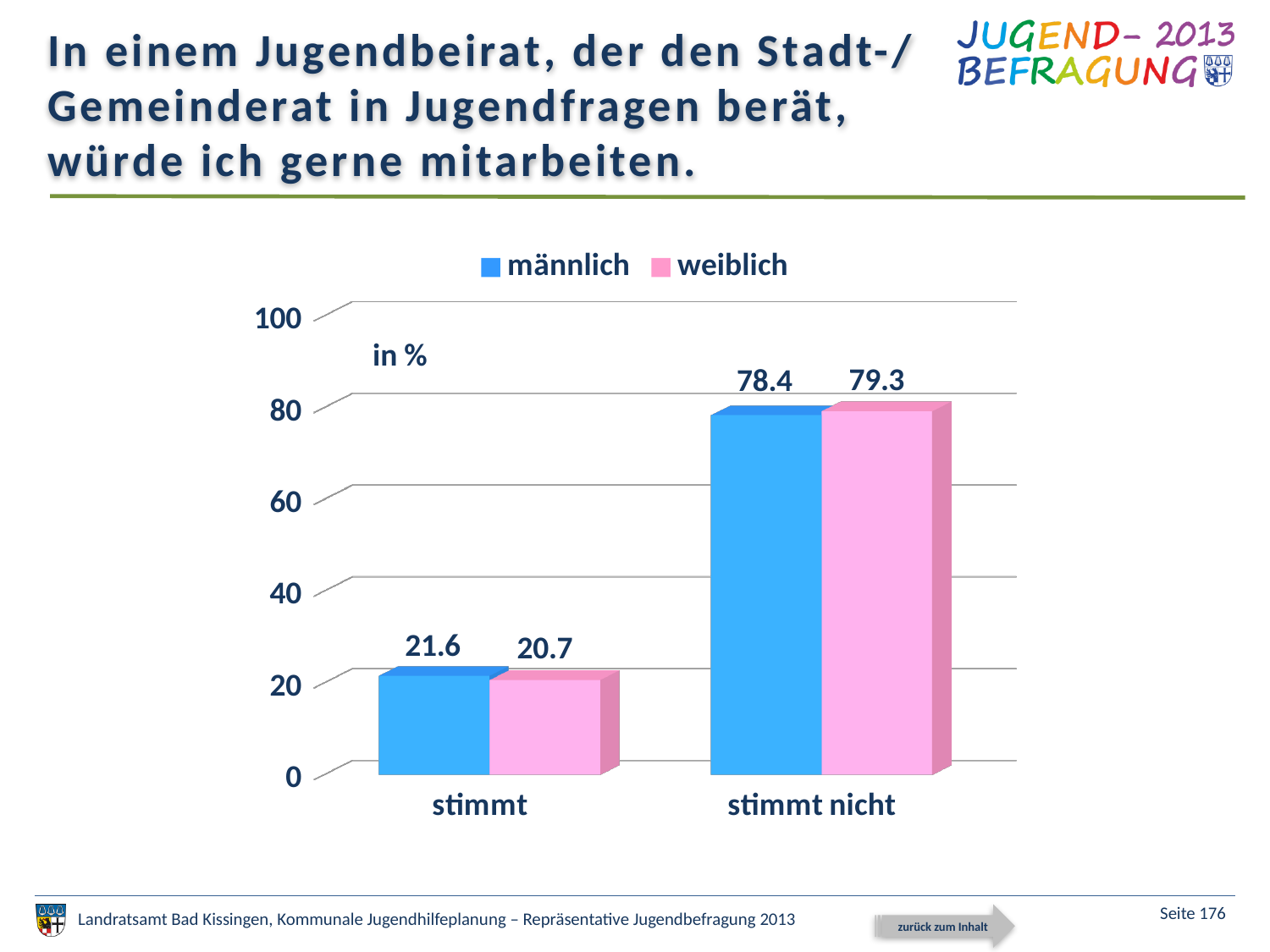
How many series does the legend list? 2 How many categories are shown on the x axis? 2 What is the value for weiblich in the stimmt category? 20.7 Which category has the highest value for männlich? stimmt nicht Which category has the lowest value for weiblich? stimmt What is the value for männlich in the stimmt nicht category? 78.4 Which is larger for weiblich: stimmt or stimmt nicht? stimmt nicht What is the value for weiblich in the stimmt nicht category? 79.3 What kind of chart is shown on the slide? bar chart What is the difference between the männlich and weiblich values in the stimmt category? 0.9 What is the value for männlich in the stimmt category? 21.6 What is the difference between the stimmt nicht and stimmt values for männlich? 56.8